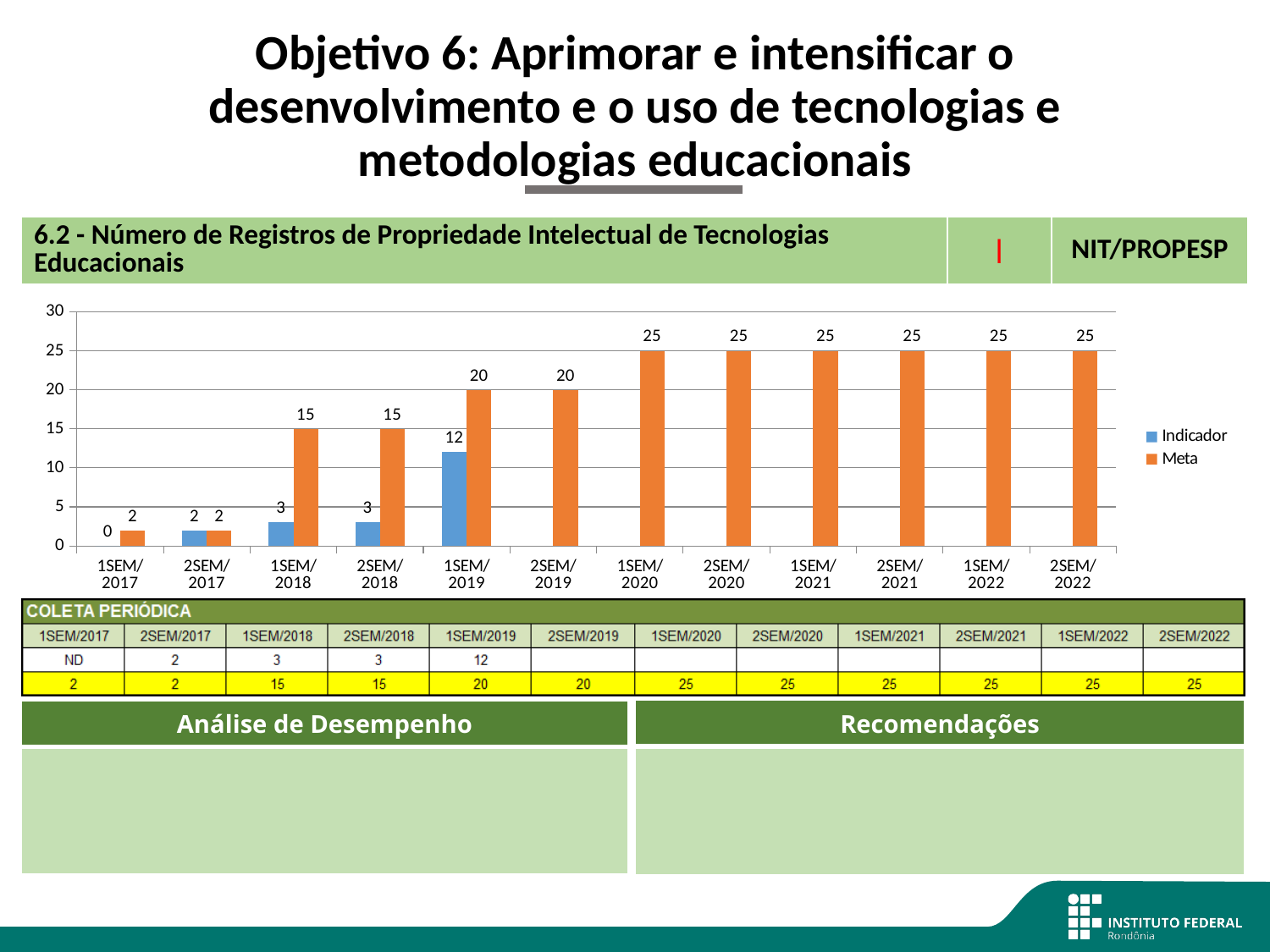
How many categories are shown on the x axis? 12 What is the difference between the Meta values for 1SEM/2018 and 1SEM/2017? 13 What kind of chart is shown on the slide? Bar chart What is the Indicador value for 1SEM/2019? 12 What is the Meta value for 1SEM/2019? 20 Which is larger for 2SEM/2018, the Indicador value or the Meta value? Meta Does the Meta series rise or fall from 1SEM/2017 to 1SEM/2020? Rise What is the Indicador value for 1SEM/2018? 3 How many series does the legend list? 2 What is the difference between the Meta and Indicador values for 1SEM/2019? 8 Which category has the highest Indicador value? 1SEM/2019 What is the Meta value for 2SEM/2022? 25